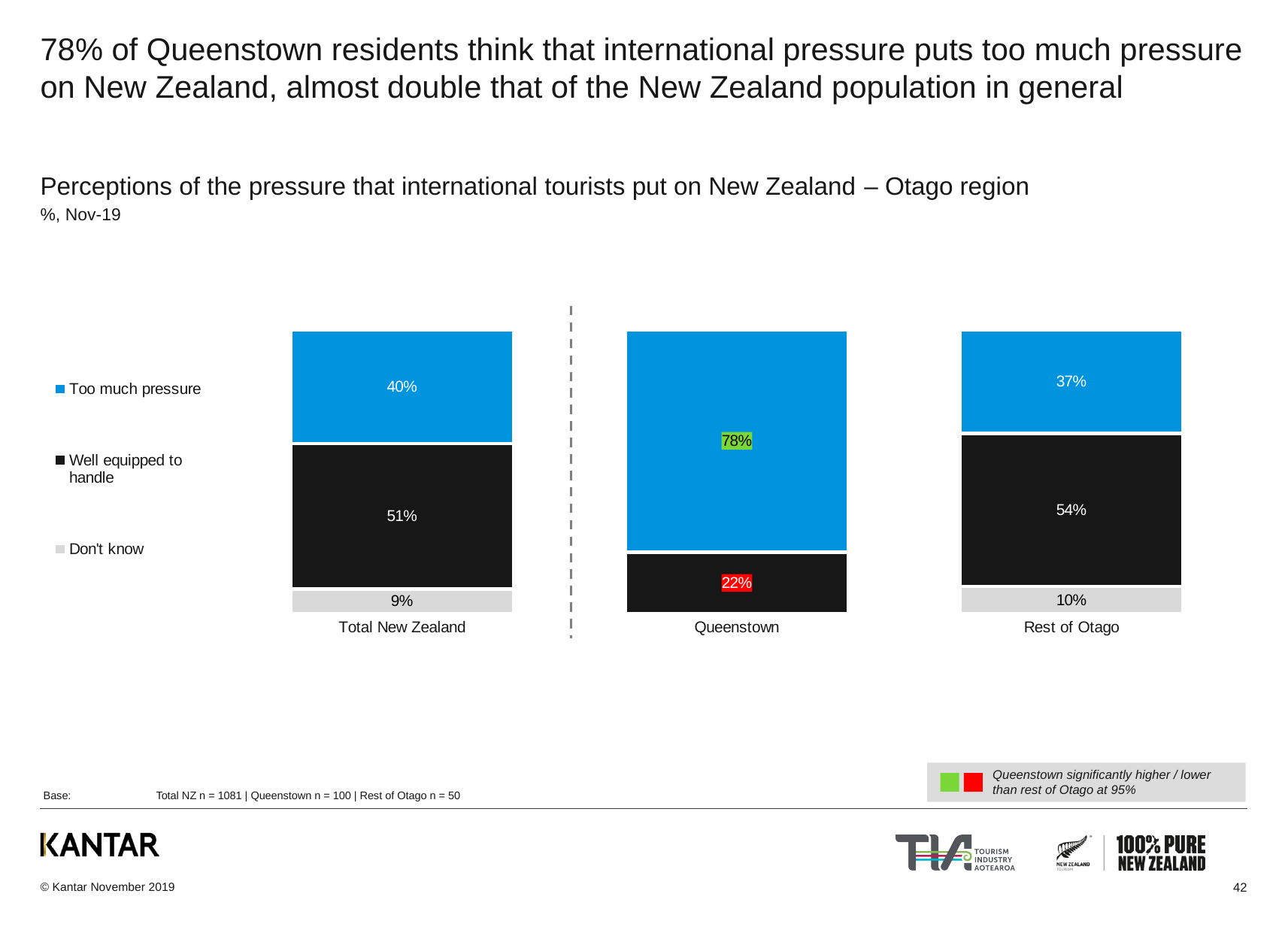
What is the 'Don't know' value for Total New Zealand? 9% What is the difference between the 'Too much pressure' values for Queenstown and Total New Zealand? 38 percentage points How many series does the legend list? 3 Which region has the highest 'Too much pressure' value? Queenstown Which region has the lowest 'Too much pressure' value? Rest of Otago What kind of chart is shown on the slide? Stacked bar chart What is the 'Well equipped to handle' value for Queenstown? 22% What is the 'Well equipped to handle' value for Rest of Otago? 54% What percentage of Queenstown respondents said international tourists put too much pressure on New Zealand? 78% Is the 'Well equipped to handle' value larger for Total New Zealand or for Rest of Otago? Rest of Otago Which legend entry is shown in blue? Too much pressure How many regions are shown on the x axis of the chart? 3